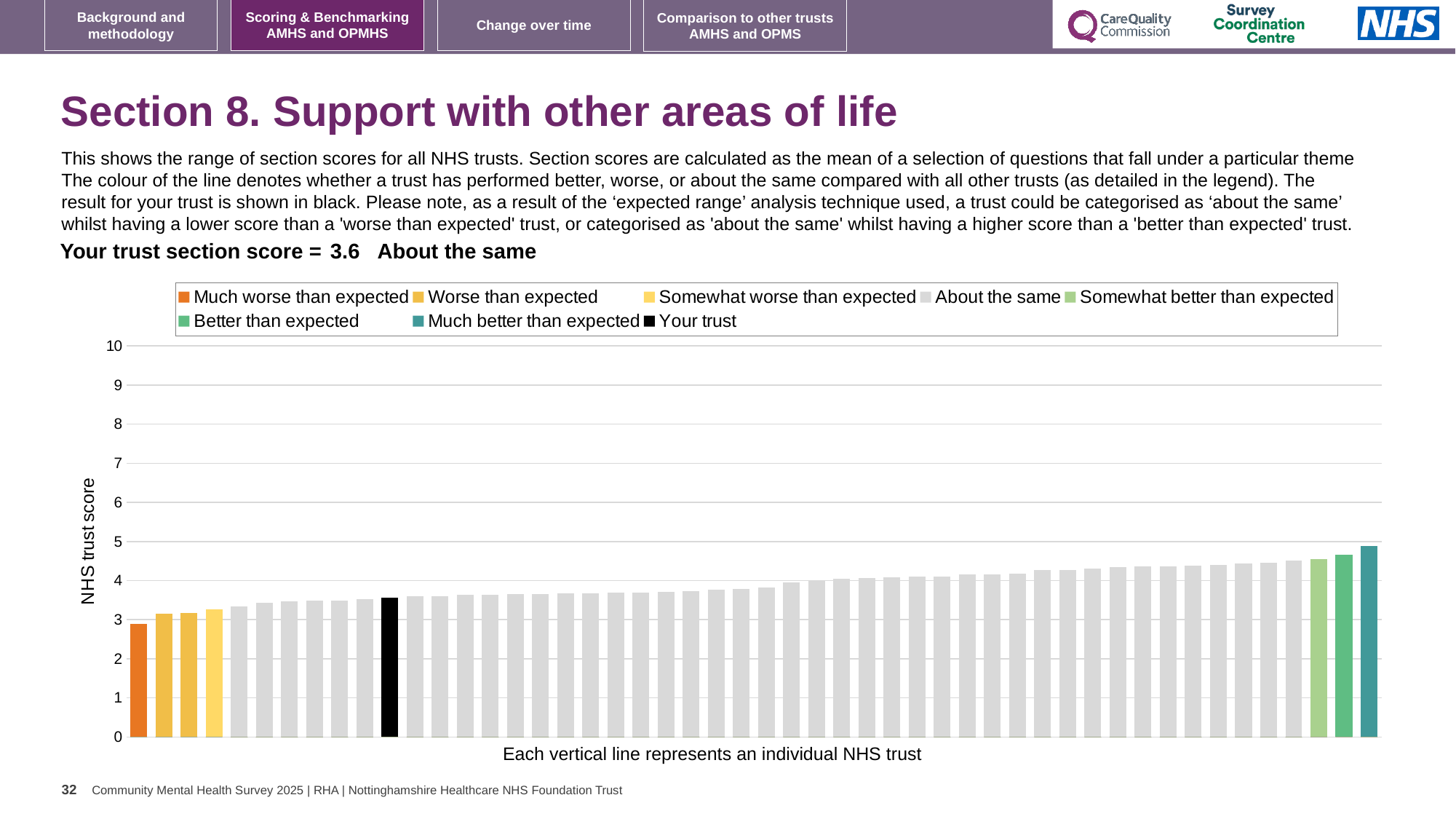
What kind of chart is shown on the slide? bar chart Which legend category does the shortest bar on the chart belong to? Much worse than expected How many entries does the chart legend list? 8 Is the value of the leftmost orange 'Much worse than expected' bar greater or less than 2? greater What is the section score for your trust shown on the slide? 3.6 Is the value of the tallest bar (the rightmost, 'Much better than expected') greater or less than 4? greater What is the label on the vertical axis of the chart? NHS trust score Is the value of the black 'Your trust' bar greater or less than 4? less Which is larger: the 'Your trust' bar or the rightmost 'Much better than expected' bar? Much better than expected Do the bar values rise or fall moving from left to right along the x axis? rise Which legend category does the tallest bar on the chart belong to? Much better than expected